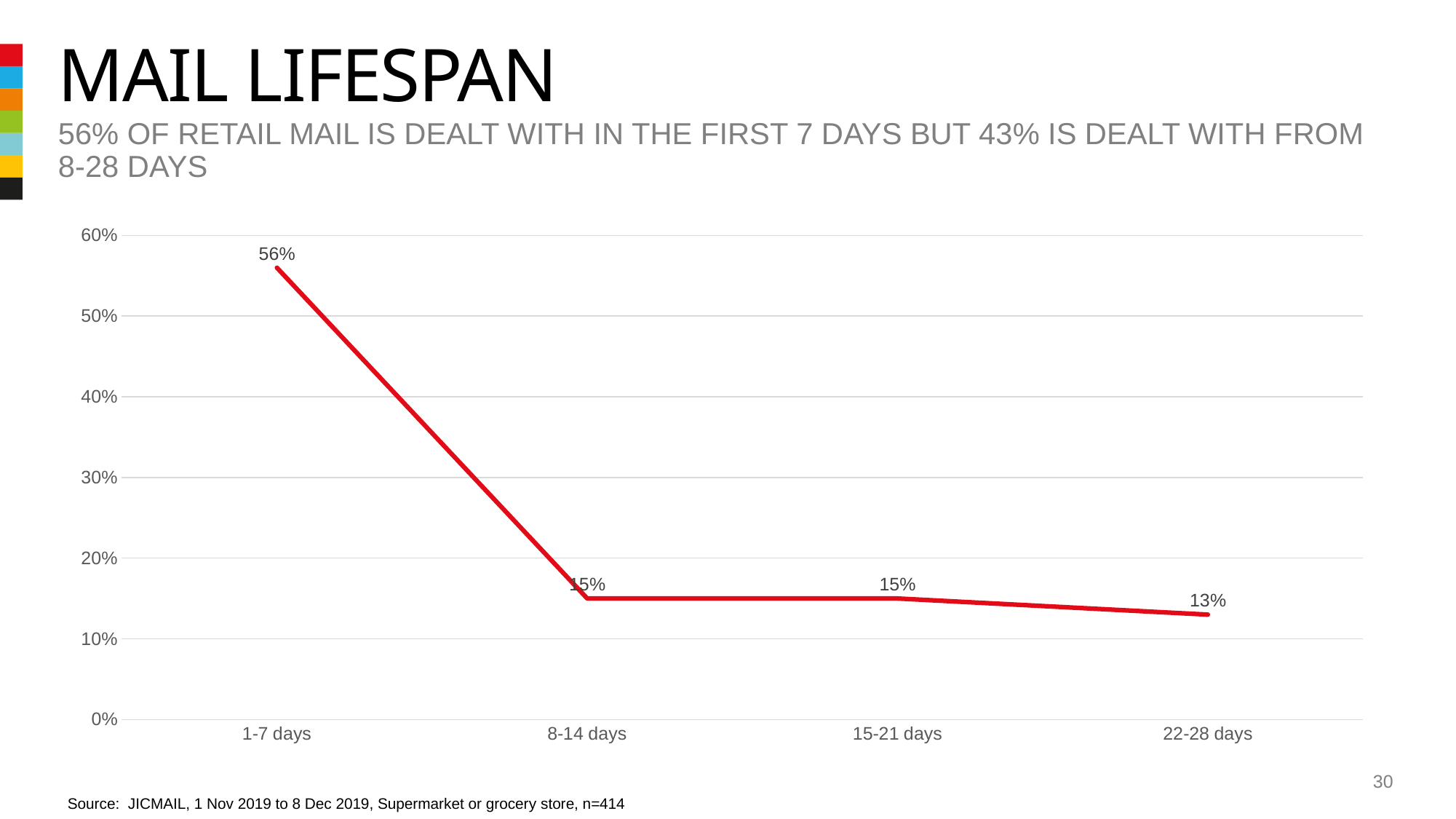
What kind of chart is shown on the slide? line chart Which category has the lowest value? 22-28 days Which category has the highest value? 1-7 days Do the values rise or fall from 1-7 days to 22-28 days? fall What is the difference between the values for 1-7 days and 8-14 days? 41% How many categories are shown on the x axis? 4 What is the difference between the values for 15-21 days and 22-28 days? 2% What is the value for 22-28 days? 13% What is the value for 8-14 days? 15% Is the value for 1-7 days greater or less than 50%? greater Which is larger, the value for 1-7 days or the value for 15-21 days? 1-7 days What is the value for 1-7 days? 56%